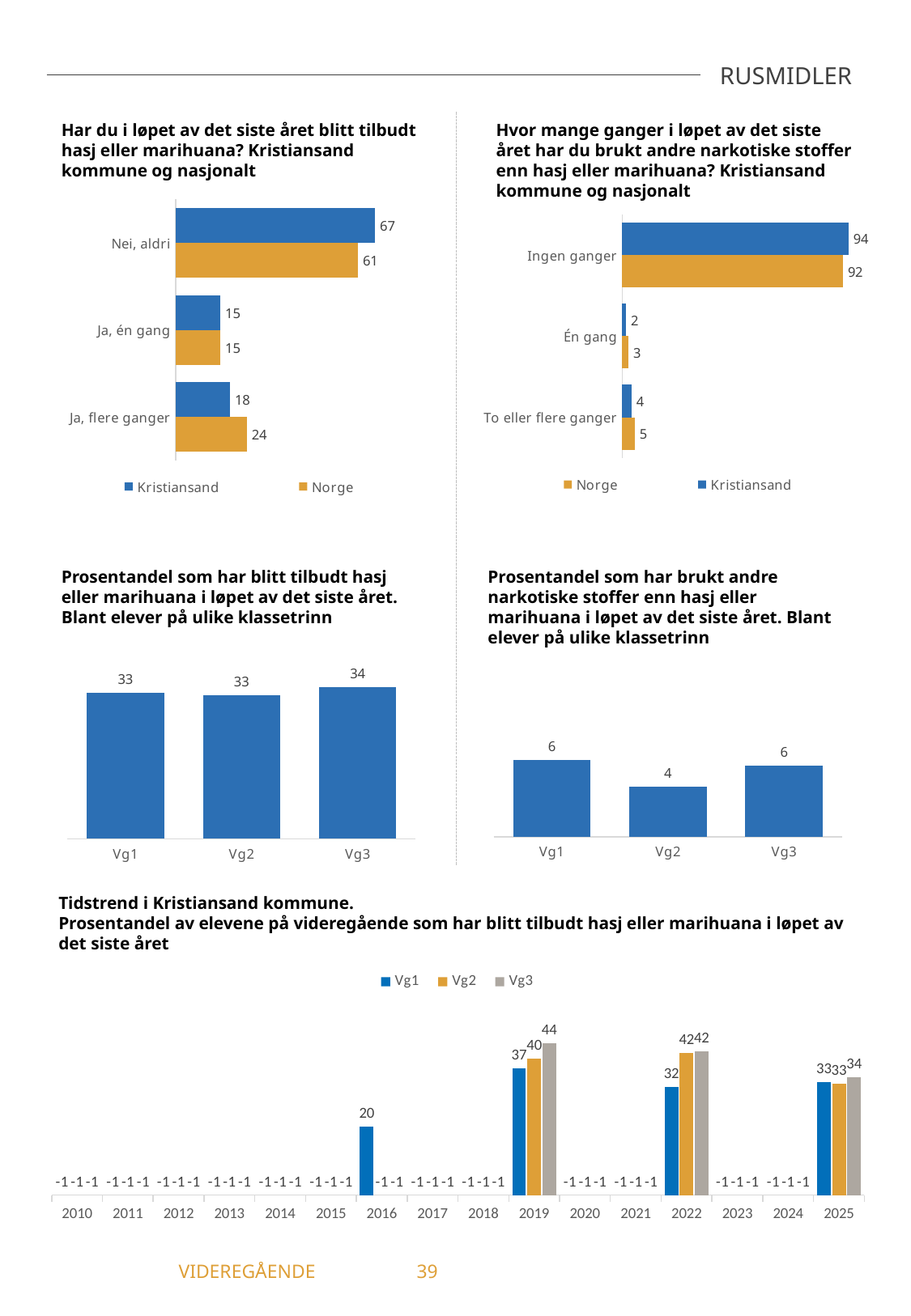
In the chart 'Prosentandel som har blitt tilbudt hasj eller marihuana i løpet av det siste året. Blant elever på ulike klassetrinn', what is the value for Vg2? 33 In the chart 'Har du i løpet av det siste året blitt tilbudt hasj eller marihuana?', what is the value for Kristiansand for 'Nei, aldri'? 67 In the chart 'Har du i løpet av det siste året blitt tilbudt hasj eller marihuana?', how many series does the legend list? 2 In the chart 'Tidstrend i Kristiansand kommune', what is the difference between the Vg1 values for 2019 and 2022? 5 In the chart 'Hvor mange ganger i løpet av det siste året har du brukt andre narkotiske stoffer enn hasj eller marihuana?', what is the value for Norge for 'Ingen ganger'? 92 In the chart 'Prosentandel som har brukt andre narkotiske stoffer enn hasj eller marihuana i løpet av det siste året. Blant elever på ulike klassetrinn', which class level has the lowest value? Vg2 In the chart 'Hvor mange ganger i løpet av det siste året har du brukt andre narkotiske stoffer enn hasj eller marihuana?', which is larger for 'To eller flere ganger', Kristiansand or Norge? Norge In the chart 'Tidstrend i Kristiansand kommune', what is the value for Vg3 in 2019? 44 In the chart 'Hvor mange ganger i løpet av det siste året har du brukt andre narkotiske stoffer enn hasj eller marihuana?', how many categories are shown? 3 In the chart 'Har du i løpet av det siste året blitt tilbudt hasj eller marihuana?', what is the difference between Norge and Kristiansand for 'Ja, flere ganger'? 6 What kind of chart is 'Prosentandel som har brukt andre narkotiske stoffer enn hasj eller marihuana i løpet av det siste året. Blant elever på ulike klassetrinn'? Bar chart In the chart 'Prosentandel som har blitt tilbudt hasj eller marihuana i løpet av det siste året. Blant elever på ulike klassetrinn', which class level has the highest value? Vg3